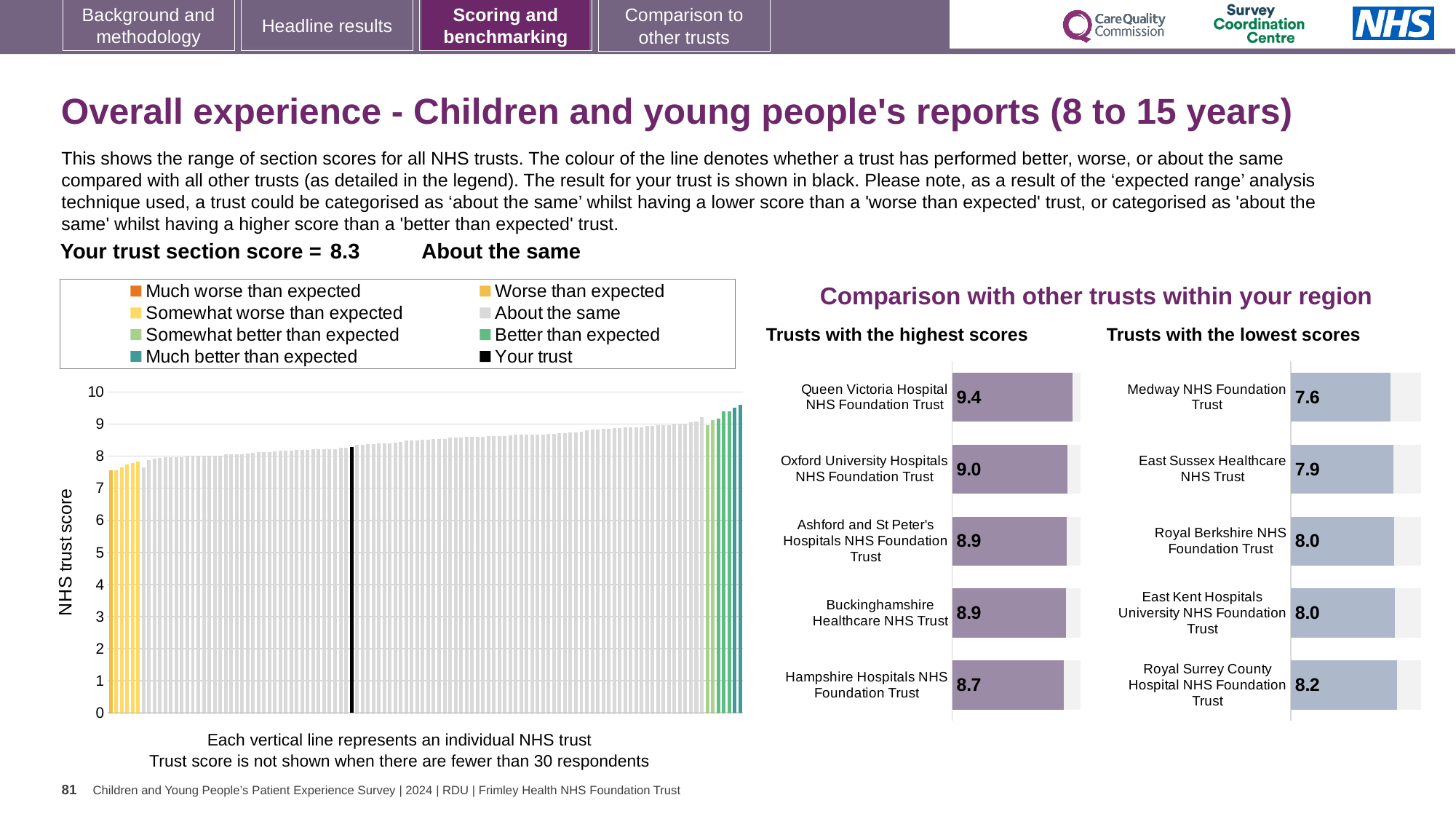
In the 'Trusts with the highest scores' chart, which trust has the lowest score shown? Hampshire Hospitals NHS Foundation Trust In the 'Trusts with the highest scores' chart, what score is shown for Oxford University Hospitals NHS Foundation Trust? 9.0 In the large 'NHS trust score' chart on the left, what colour is the bar for 'Your trust'? Black How many trusts are listed in the 'Trusts with the lowest scores' chart? 5 In the 'Trusts with the lowest scores' chart, which has the larger score: East Sussex Healthcare NHS Trust or Royal Berkshire NHS Foundation Trust? Royal Berkshire NHS Foundation Trust How many entries does the legend of the large 'NHS trust score' chart on the left list? 8 In the 'Trusts with the highest scores' chart, what is the difference between the scores of Queen Victoria Hospital NHS Foundation Trust and Hampshire Hospitals NHS Foundation Trust? 0.7 What kind of chart is the large chart on the left with the 'NHS trust score' axis? Bar chart In the large 'NHS trust score' chart on the left, do the bar values rise or fall from left to right? Rise In the 'Trusts with the lowest scores' chart, what is the score for Medway NHS Foundation Trust? 7.6 In the 'Trusts with the lowest scores' chart, which trust has the highest score shown? Royal Surrey County Hospital NHS Foundation Trust In the 'Trusts with the highest scores' chart, what is the score for Queen Victoria Hospital NHS Foundation Trust? 9.4